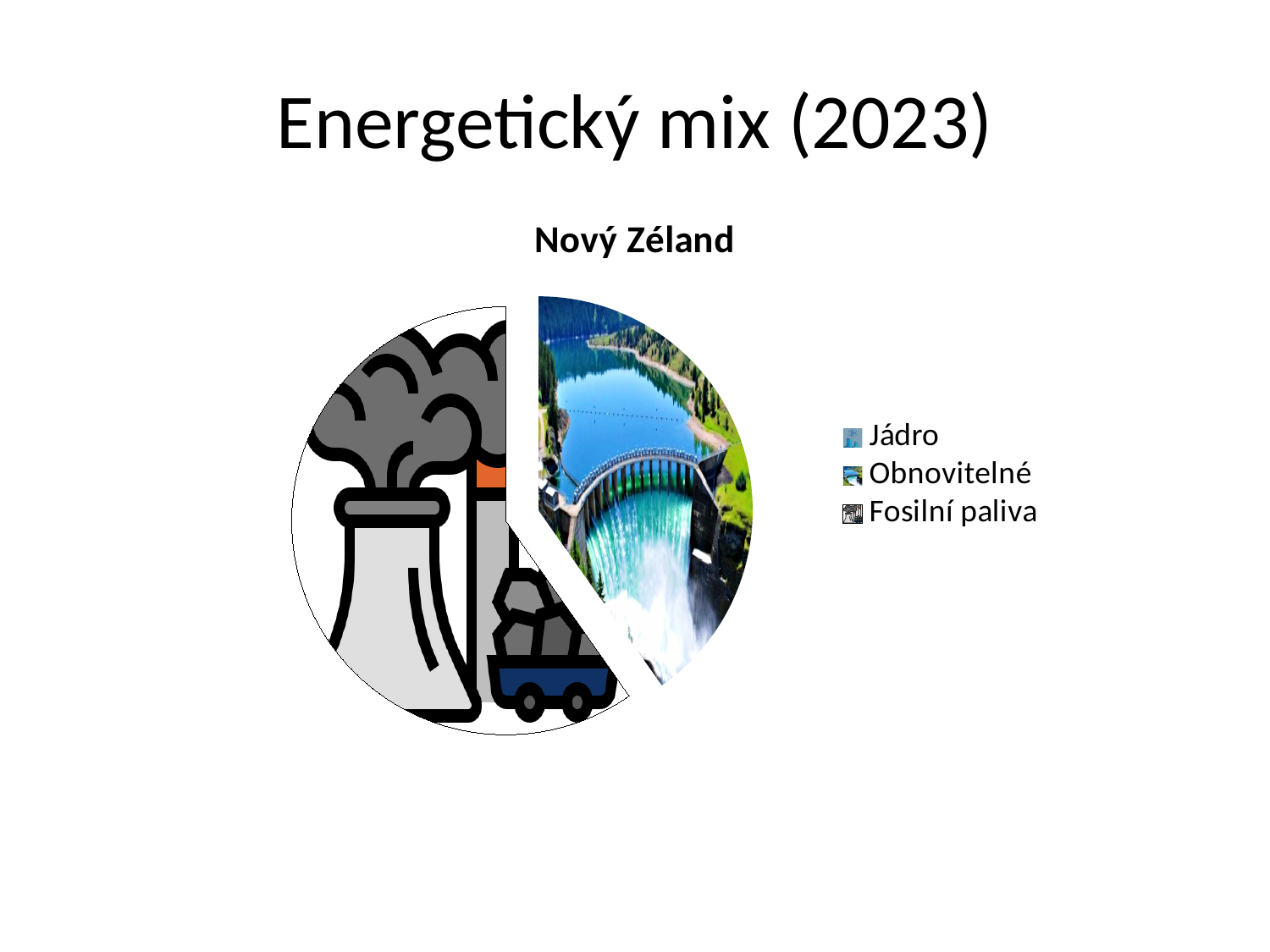
How many categories does the chart's legend list? 3 Which categories are listed in the chart's legend? Jádro, Obnovitelné, Fosilní paliva Which slice of the pie chart is larger: Obnovitelné or Fosilní paliva? Fosilní paliva Which category has the largest slice in the pie chart? Fosilní paliva What kind of chart is shown on the slide? pie chart What is the title of the chart? Nový Zéland